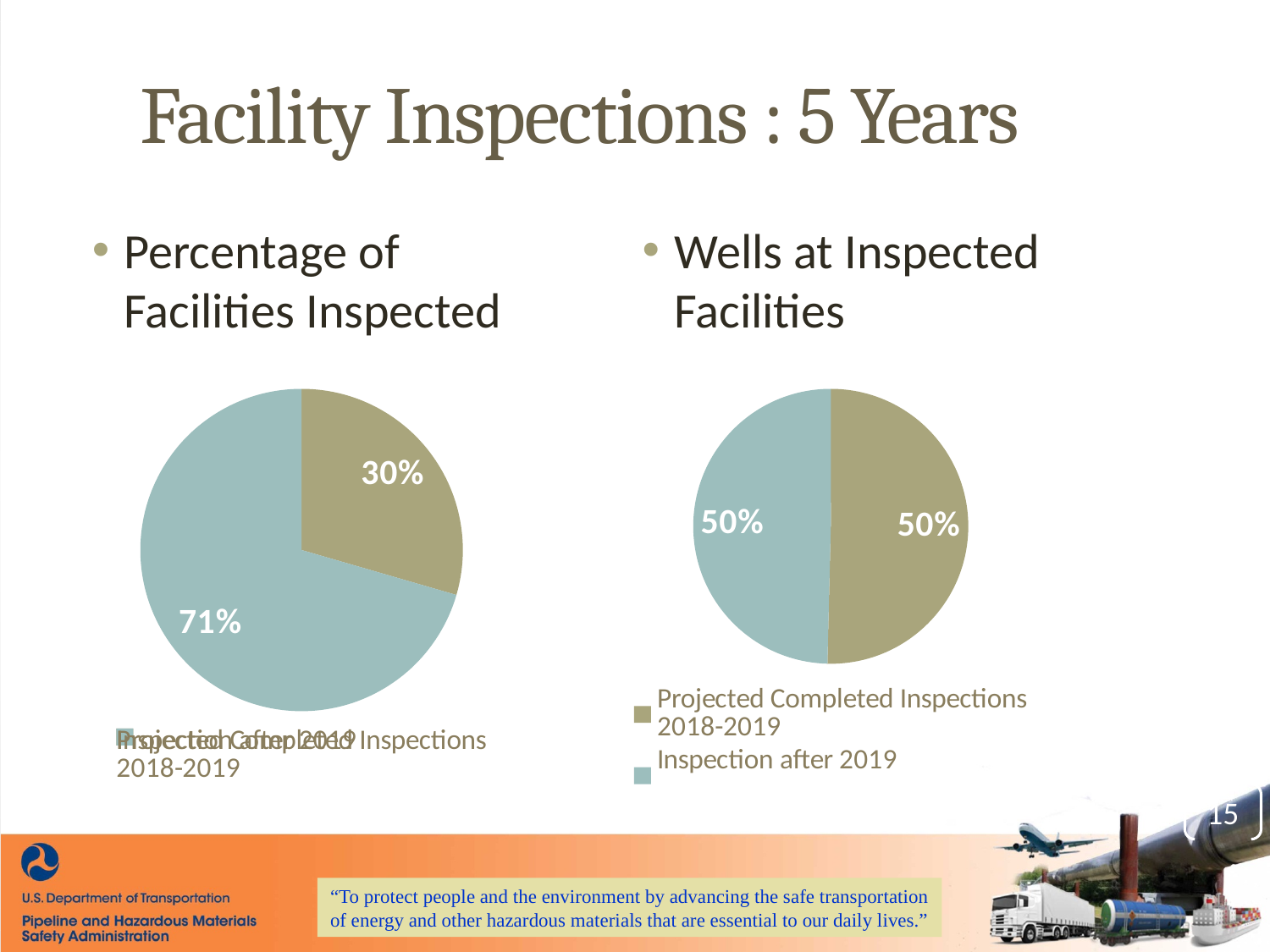
In the "Percentage of Facilities Inspected" pie chart, what is the difference between the two slice values? 41 percentage points In the "Wells at Inspected Facilities" pie chart, are the two slices equal in value? Yes In the "Percentage of Facilities Inspected" pie chart, how many slices are there? 2 In the "Wells at Inspected Facilities" pie chart, what is the value for "Inspection after 2019"? 50% In the "Percentage of Facilities Inspected" pie chart, what value is shown on the larger slice? 71% In the "Percentage of Facilities Inspected" pie chart, which slice is larger, the teal one or the tan one? The teal one What kind of chart is the chart under "Wells at Inspected Facilities"? Pie chart In the "Wells at Inspected Facilities" pie chart, what are the two legend entries? Projected Completed Inspections 2018-2019; Inspection after 2019 In the "Wells at Inspected Facilities" pie chart, how many entries does the legend list? 2 In the "Wells at Inspected Facilities" pie chart, what is the value for "Projected Completed Inspections 2018-2019"? 50% What kind of chart is the chart under "Percentage of Facilities Inspected"? Pie chart In the "Percentage of Facilities Inspected" pie chart, what value is shown on the smaller slice? 30%